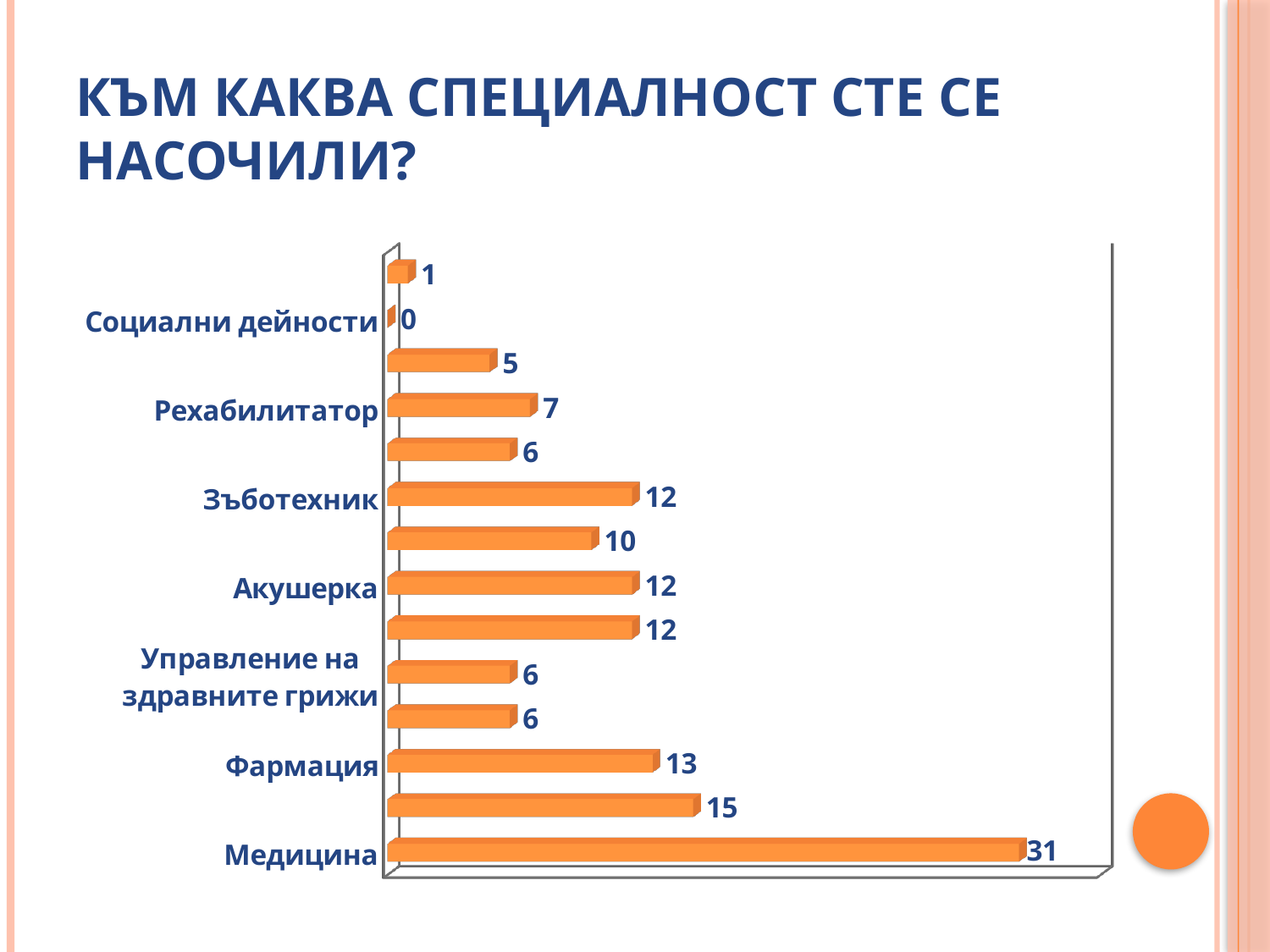
Which category has the highest value? Медицина Which labelled category has the lowest value? Социални дейности What is the value for Социални дейности? 0 Which is larger, the value for Зъботехник or the value for Рехабилитатор? Зъботехник What type of chart is shown on the slide? bar chart What is the value for Рехабилитатор? 7 What is the value for Акушерка? 12 How many bars are plotted in the chart? 14 What is the value for Фармация? 13 What is the difference between the values for Медицина and Фармация? 18 What is the value for Медицина? 31 What is the value for Управление на здравните грижи? 6